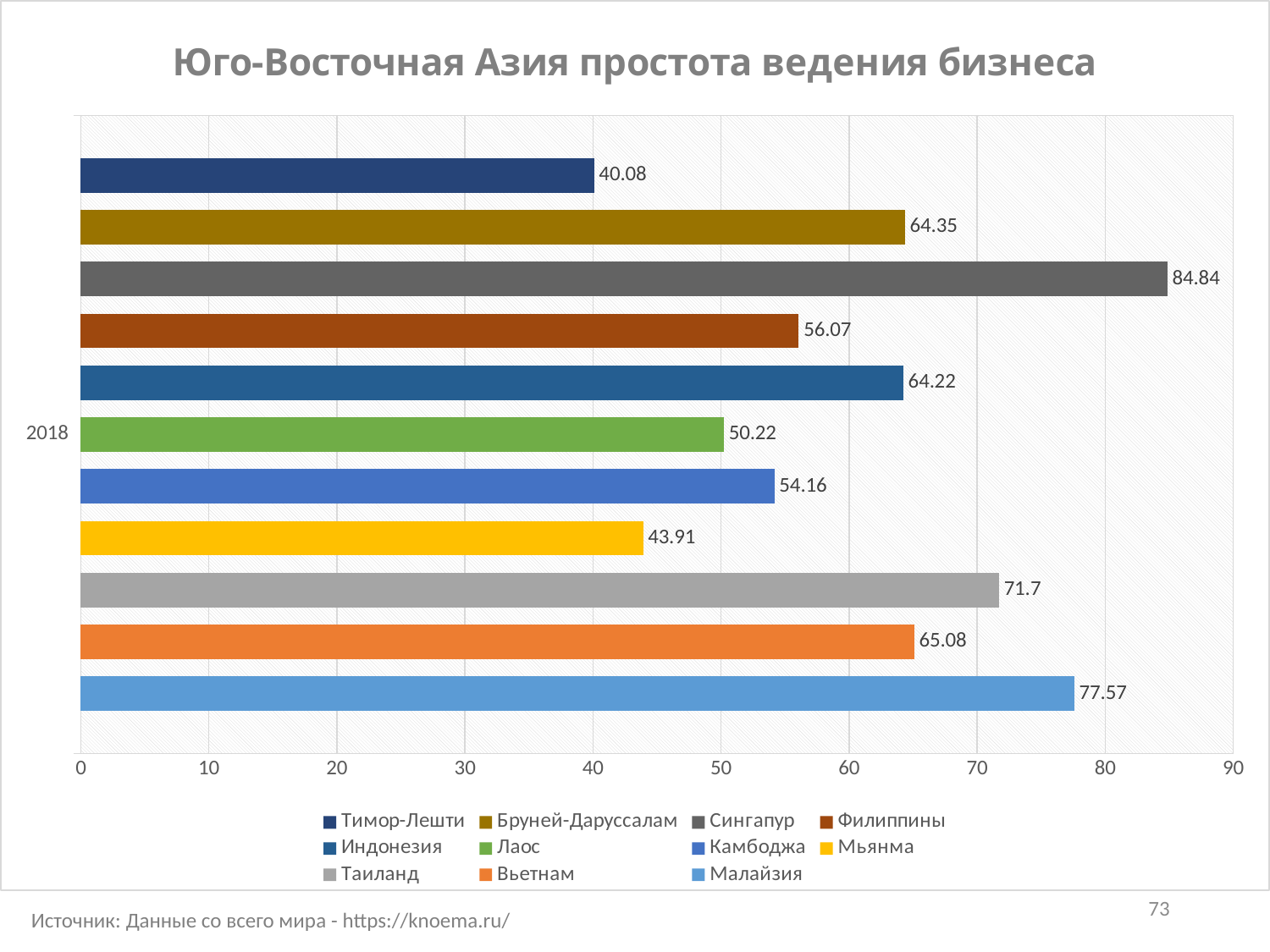
What kind of chart is shown on the slide? Bar chart Which is larger, the value for Филиппины or the value for Камбоджа? Филиппины What is the value for Малайзия? 77.57 What is the difference between the values for Сингапур and Тимор-Лешти? 44.76 What is the value for Таиланд? 71.7 What is the value for Сингапур? 84.84 What is the difference between the values for Вьетнам and Лаос? 14.86 Which country has the highest value? Сингапур What is the value for Мьянма? 43.91 What is the title of the chart? Юго-Восточная Азия простота ведения бизнеса Which country has the lowest value? Тимор-Лешти How many series does the legend list? 11